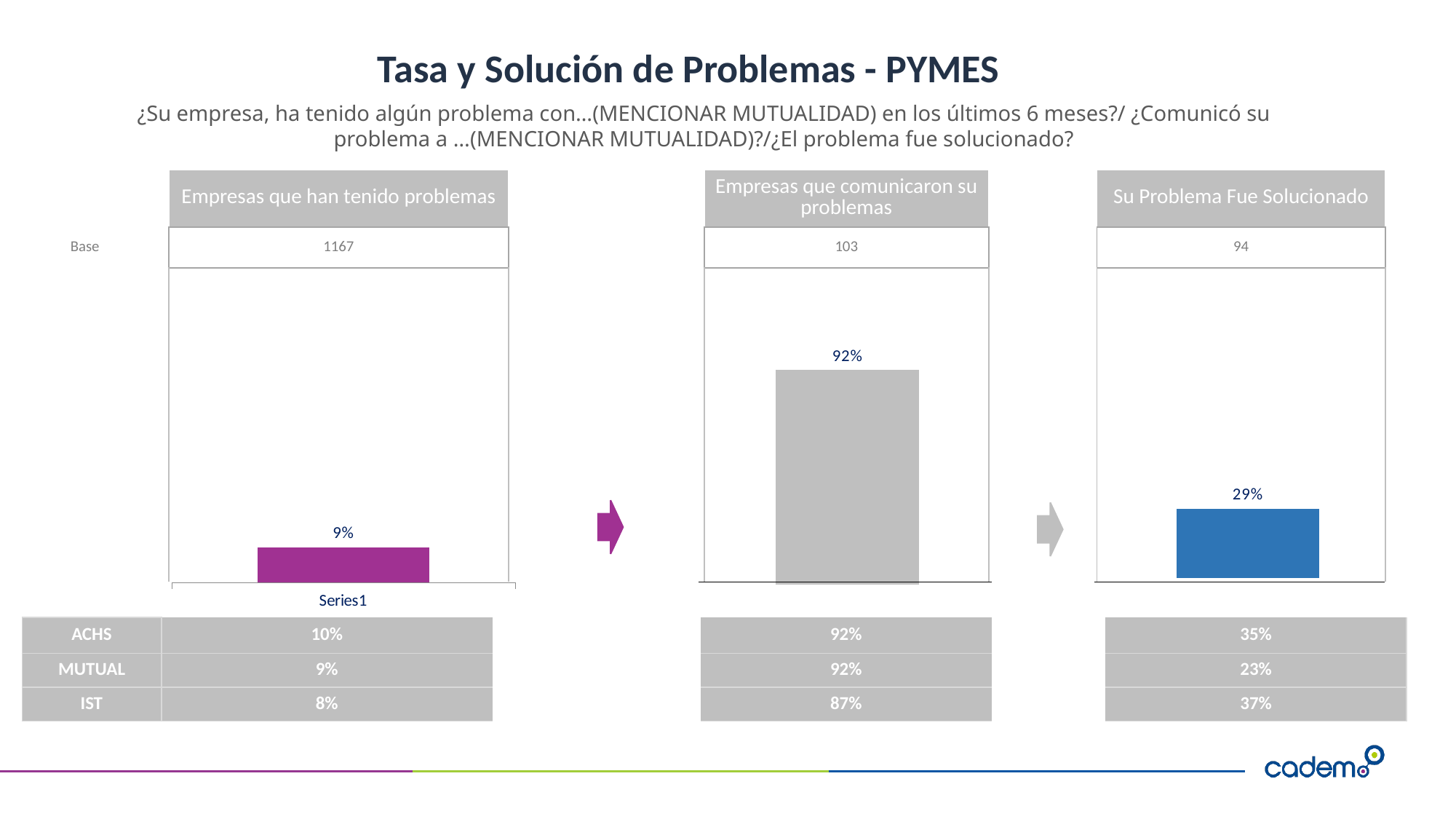
What is the x-axis category label shown under the bar in the chart titled "Empresas que han tenido problemas"? Series1 In the chart titled "Su Problema Fue Solucionado", what value is shown on the bar? 29% What base (Base) is shown above the chart titled "Empresas que han tenido problemas"? 1167 What kind of chart is the chart titled "Su Problema Fue Solucionado"? bar chart Is the bar value in the chart "Su Problema Fue Solucionado" larger or smaller than the bar value in the chart "Empresas que han tenido problemas"? larger What is the difference between the bar value in the chart "Empresas que comunicaron su problemas" and the bar value in the chart "Su Problema Fue Solucionado"? 63% Which of the three charts on the slide shows the highest bar value? Empresas que comunicaron su problemas How many bars are plotted in the chart titled "Empresas que comunicaron su problemas"? 1 In the chart titled "Empresas que comunicaron su problemas", what value is shown on the bar? 92% What kind of chart is the chart titled "Empresas que han tenido problemas"? bar chart Which of the three charts on the slide shows the lowest bar value? Empresas que han tenido problemas In the chart titled "Empresas que han tenido problemas", what value is shown on the bar? 9%